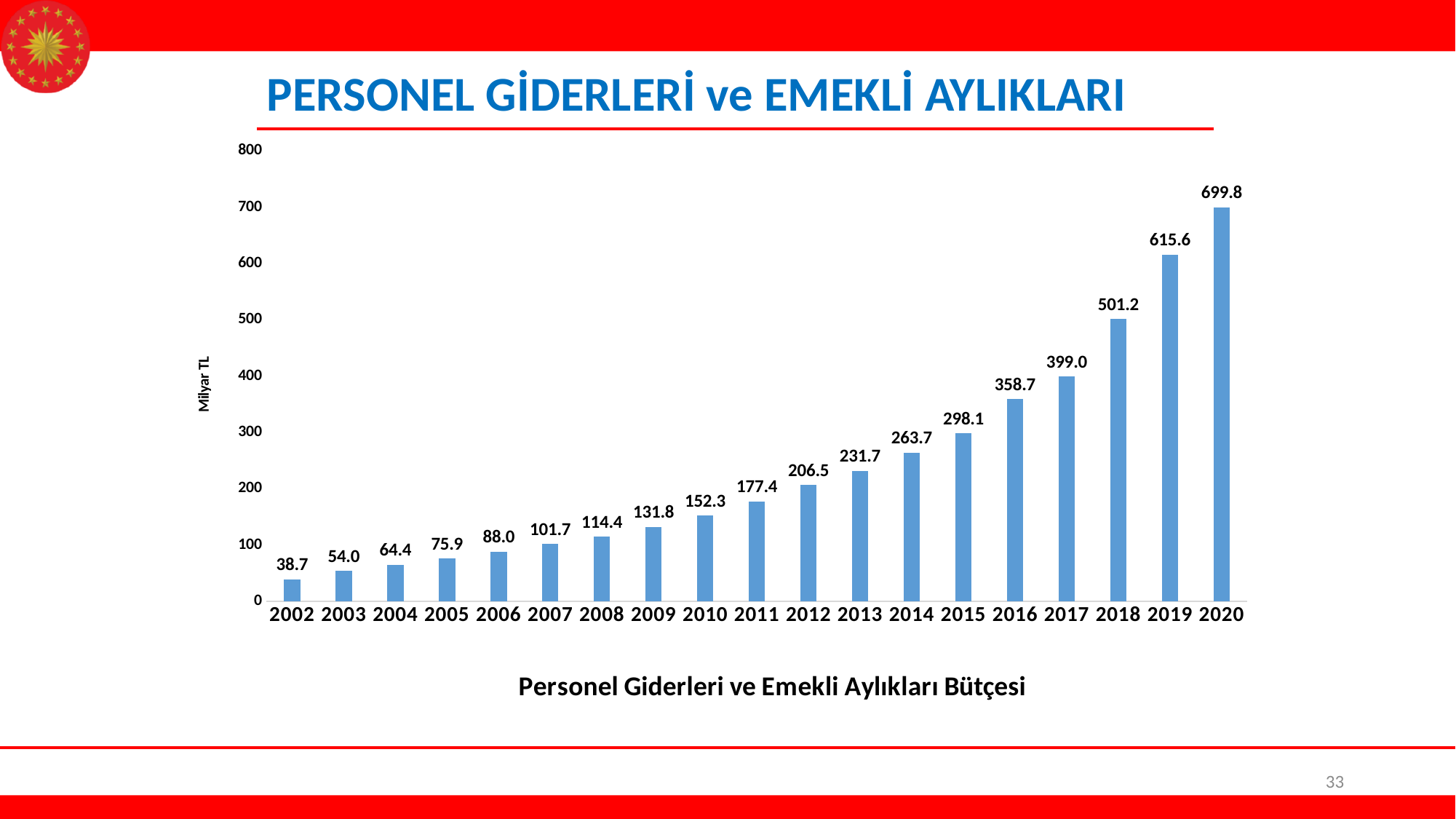
Which year has the highest value? 2020 What is the value for 2002? 38.7 What kind of chart is this? bar chart What is the value for 2018? 501.2 What is the difference between the values for 2020 and 2019? 84.2 Is the value for 2017 greater or less than 400? less Do the values rise or fall from 2002 to 2020? rise What is the value for 2010? 152.3 How many years are shown on the x axis? 19 What is the difference between the values for 2012 and 2011? 29.1 Which year has the lowest value? 2002 Which is larger, the value for 2015 or the value for 2014? 2015